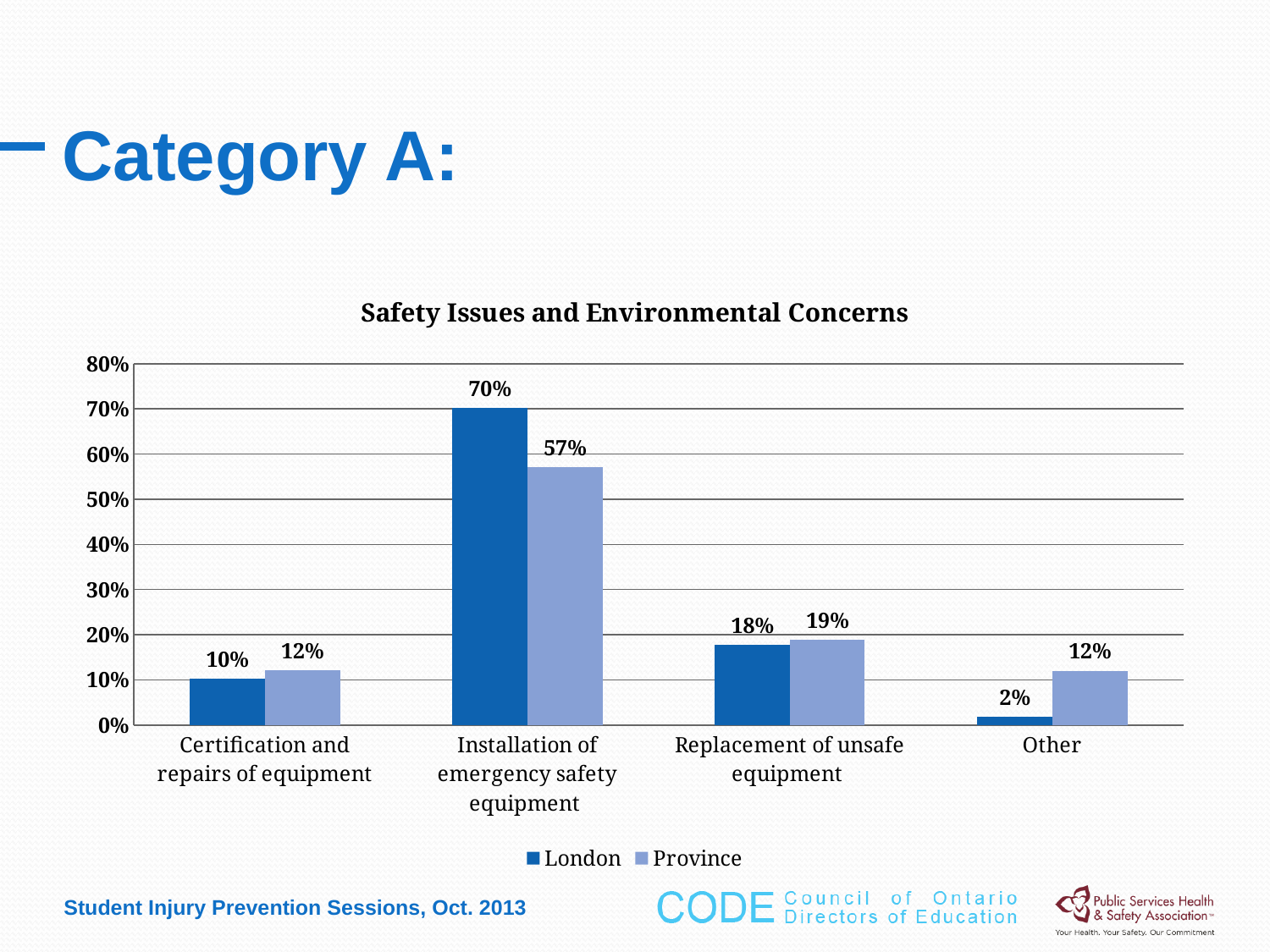
Which category has the lowest London value? Other What is the title of the chart? Safety Issues and Environmental Concerns What is the Province value for Other? 12% What kind of chart is shown on the slide? Bar chart What is the London value for Installation of emergency safety equipment? 70% How many series does the legend list? 2 How many categories are shown on the x axis? 4 What is the difference between the London and Province values for Installation of emergency safety equipment? 13% What is the difference between the Province and London values for Other? 10% What is the London value for Replacement of unsafe equipment? 18% Which category has the highest Province value? Installation of emergency safety equipment Which is larger for Certification and repairs of equipment, the London value or the Province value? Province